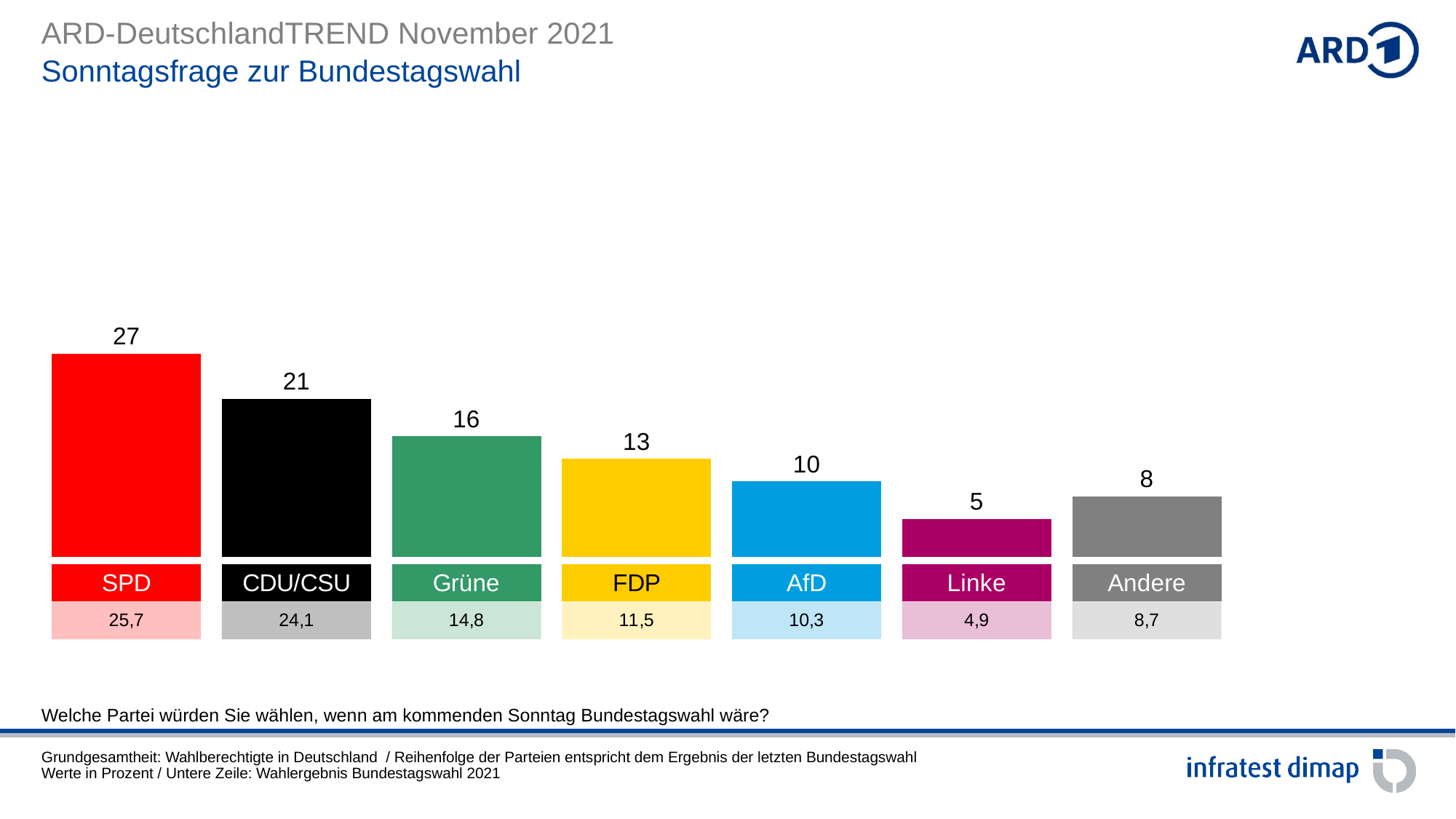
Which party has the lowest value in the bar chart? Linke What is the value shown for Grüne in the bar chart? 16 Which party has the highest value in the bar chart? SPD Which has a larger value, FDP or AfD? FDP What is the title of the chart on the slide? Sonntagsfrage zur Bundestagswahl What is the value shown for SPD in the bar chart? 27 How many parties (categories) are shown in the bar chart? 7 What is the value shown for AfD in the bar chart? 10 What is the difference between the values for SPD and CDU/CSU? 6 What is the Bundestagswahl 2021 result shown in the lower row for CDU/CSU? 24,1 Do the bar values rise or fall from left to right across the first six parties? fall What kind of chart is shown on the slide? bar chart